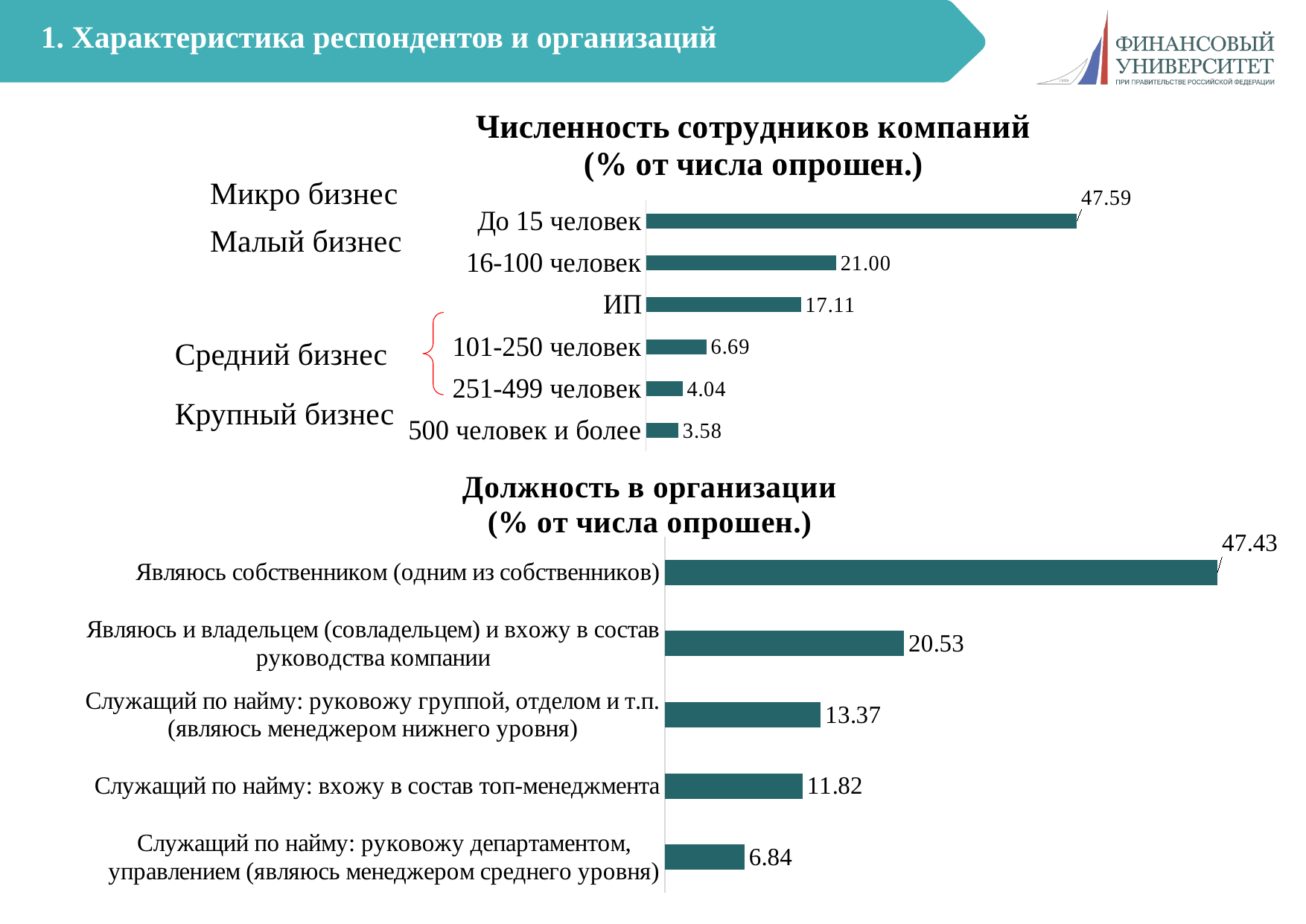
In the chart "Численность сотрудников компаний", how many categories are shown? 6 In the chart "Численность сотрудников компаний", which is larger: "251-499 человек" or "500 человек и более"? 251-499 человек In the chart "Численность сотрудников компаний", what is the value for "До 15 человек"? 47.59 In the chart "Численность сотрудников компаний", what is the difference between "16-100 человек" and "101-250 человек"? 14.31 In the chart "Должность в организации", how many categories are shown? 5 In the chart "Должность в организации", what is the value for "Являюсь и владельцем (совладельцем) и вхожу в состав руководства компании"? 20.53 In the chart "Должность в организации", which category has the highest value? Являюсь собственником (одним из собственников) In the chart "Должность в организации", what is the value for "Служащий по найму: вхожу в состав топ-менеджмента"? 11.82 What type of chart is the bottom chart "Должность в организации"? Bar chart In the chart "Численность сотрудников компаний", what is the value for "ИП"? 17.11 In the chart "Численность сотрудников компаний", which category has the lowest value? 500 человек и более In the chart "Должность в организации", what is the difference between the highest and lowest values? 40.59